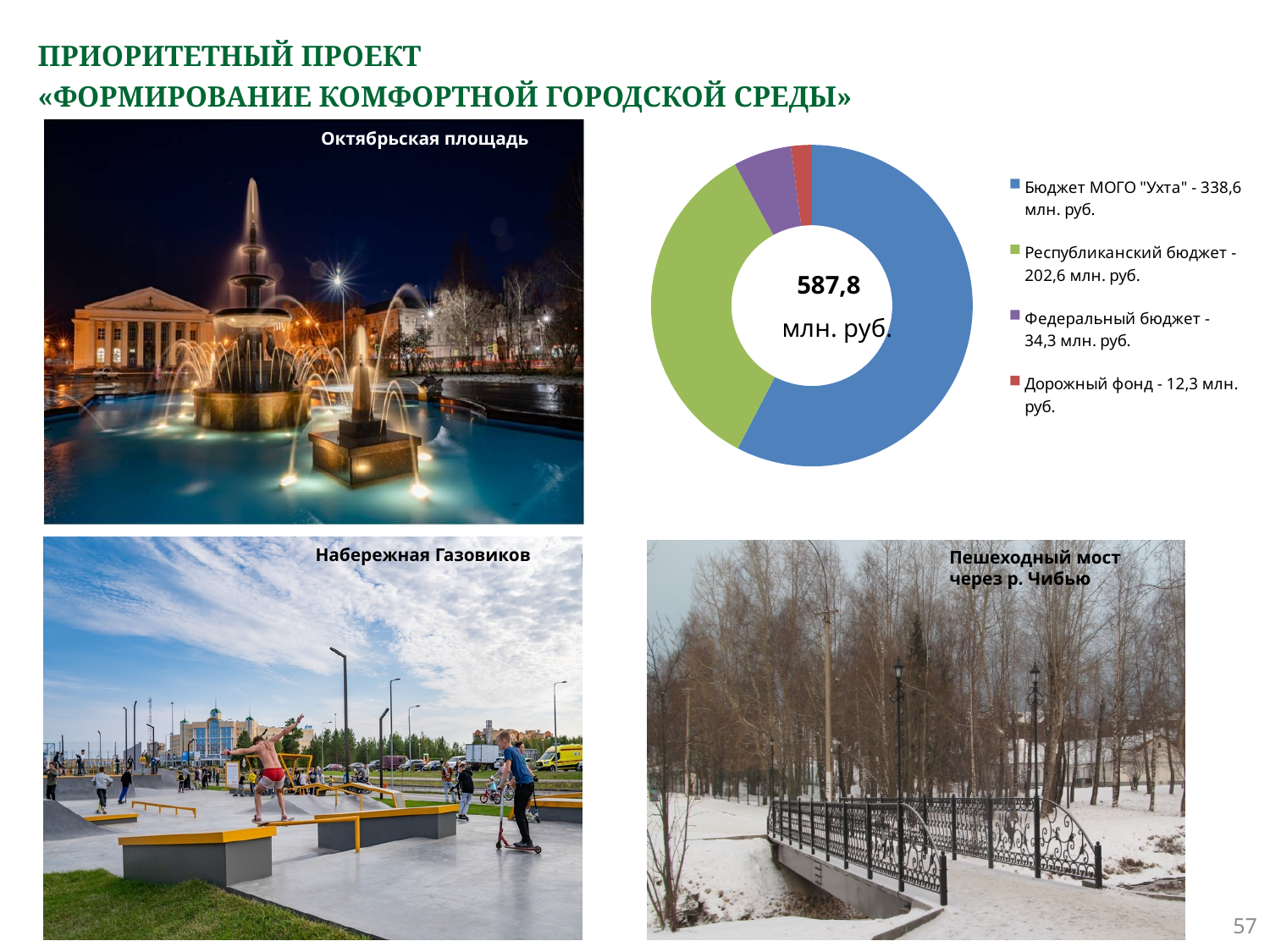
What type of chart is shown on the slide? Doughnut (pie) chart Which is larger: Федеральный бюджет or Дорожный фонд? Федеральный бюджет Which category has the smallest share of the doughnut chart? Дорожный фонд What total value is printed in the centre of the doughnut chart? 587,8 млн. руб. What colour is the slice for Республиканский бюджет in the doughnut chart? Green How many categories does the doughnut chart show? 4 What is the difference between Бюджет МОГО "Ухта" and Республиканский бюджет? 136,0 млн. руб. What is the value for Бюджет МОГО "Ухта" in the doughnut chart? 338,6 млн. руб. What is the value for Дорожный фонд in the doughnut chart? 12,3 млн. руб. What is the value for Федеральный бюджет in the doughnut chart? 34,3 млн. руб. Which category has the largest share of the doughnut chart? Бюджет МОГО "Ухта" What is the value for Республиканский бюджет in the doughnut chart? 202,6 млн. руб.